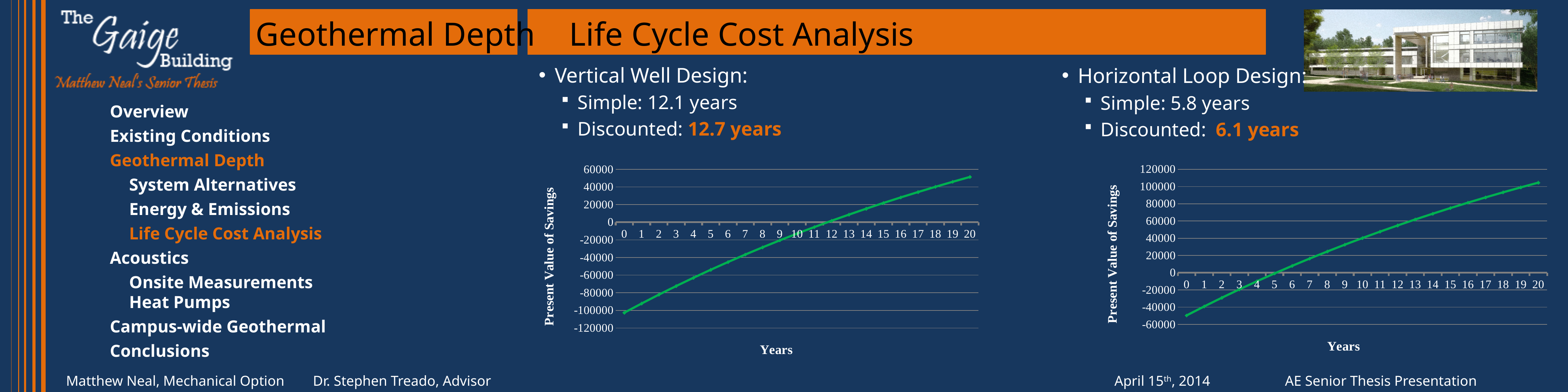
What kind of chart is shown under the Vertical Well Design heading? line chart In the Horizontal Loop Design chart, is the value at year 0 greater or less than -40000? less In the Vertical Well Design chart, do the values rise or fall as the years increase? rise What is the y-axis label of the Vertical Well Design chart? Present Value of Savings In the Vertical Well Design chart, is the value at year 20 greater or less than 40000? greater What kind of chart is shown under the Horizontal Loop Design heading? line chart In the Horizontal Loop Design chart, is the value at year 20 greater or less than 80000? greater In the Horizontal Loop Design chart, at which year is the present value of savings lowest? 0 In the Vertical Well Design chart, at which year is the present value of savings highest? 20 In the Horizontal Loop Design chart, do the values rise or fall as the years increase? rise